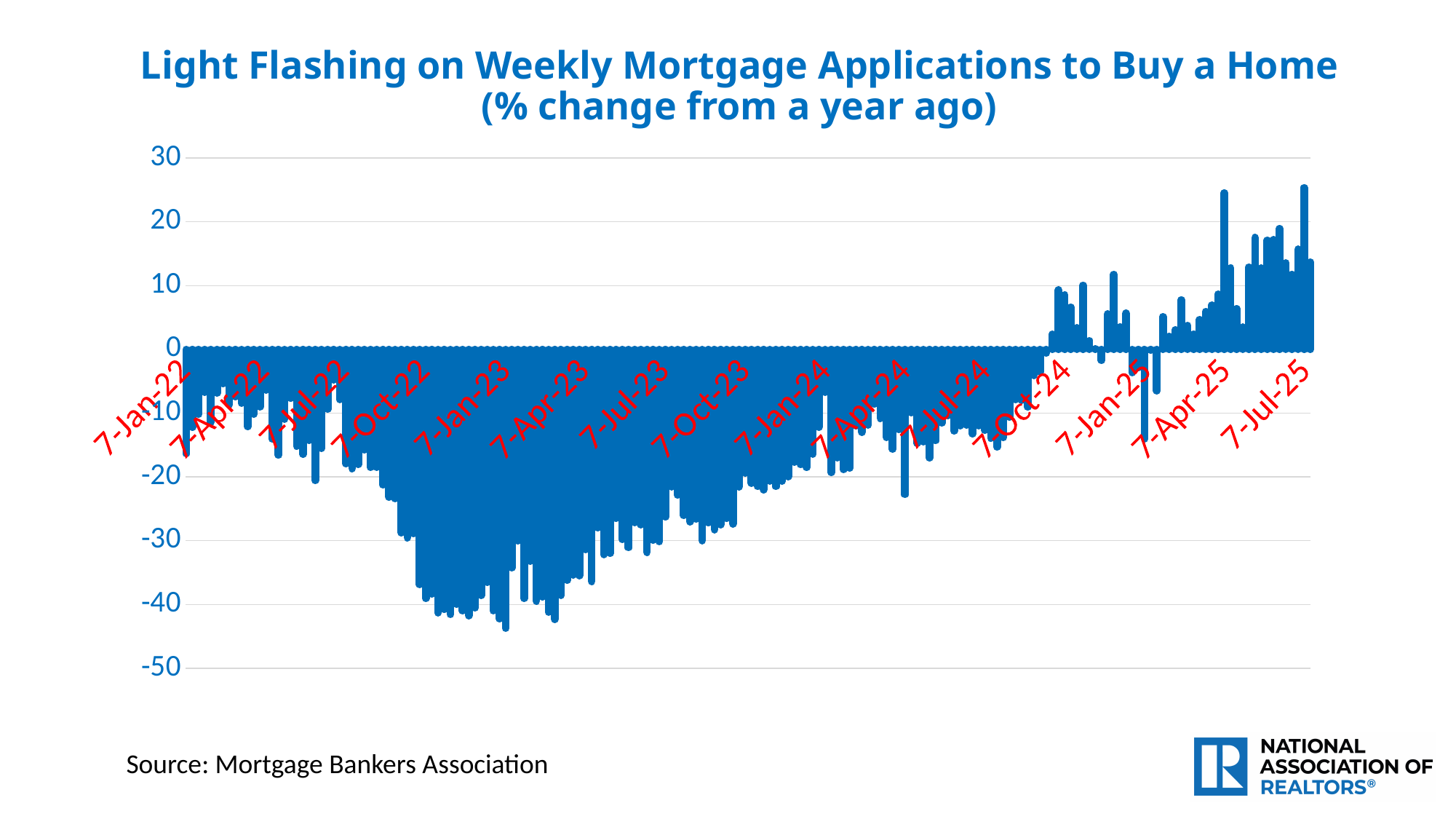
Is the value at 7-Jan-23 greater or less than -30? less Is the value at 7-Apr-25 greater or less than -10? greater How many date labels are shown on the x axis? 15 What kind of chart is shown on the slide? Bar chart Is the value at 7-Oct-23 greater or less than -10? less What is the title of the chart? Light Flashing on Weekly Mortgage Applications to Buy a Home (% change from a year ago) Do the values generally rise or fall from 7-Jan-23 to 7-Jul-25? rise What source is cited for the chart data? Mortgage Bankers Association Which is larger, the value at 7-Jan-23 or the value at 7-Jul-25? 7-Jul-25 What is the lowest value shown on the y axis? -50